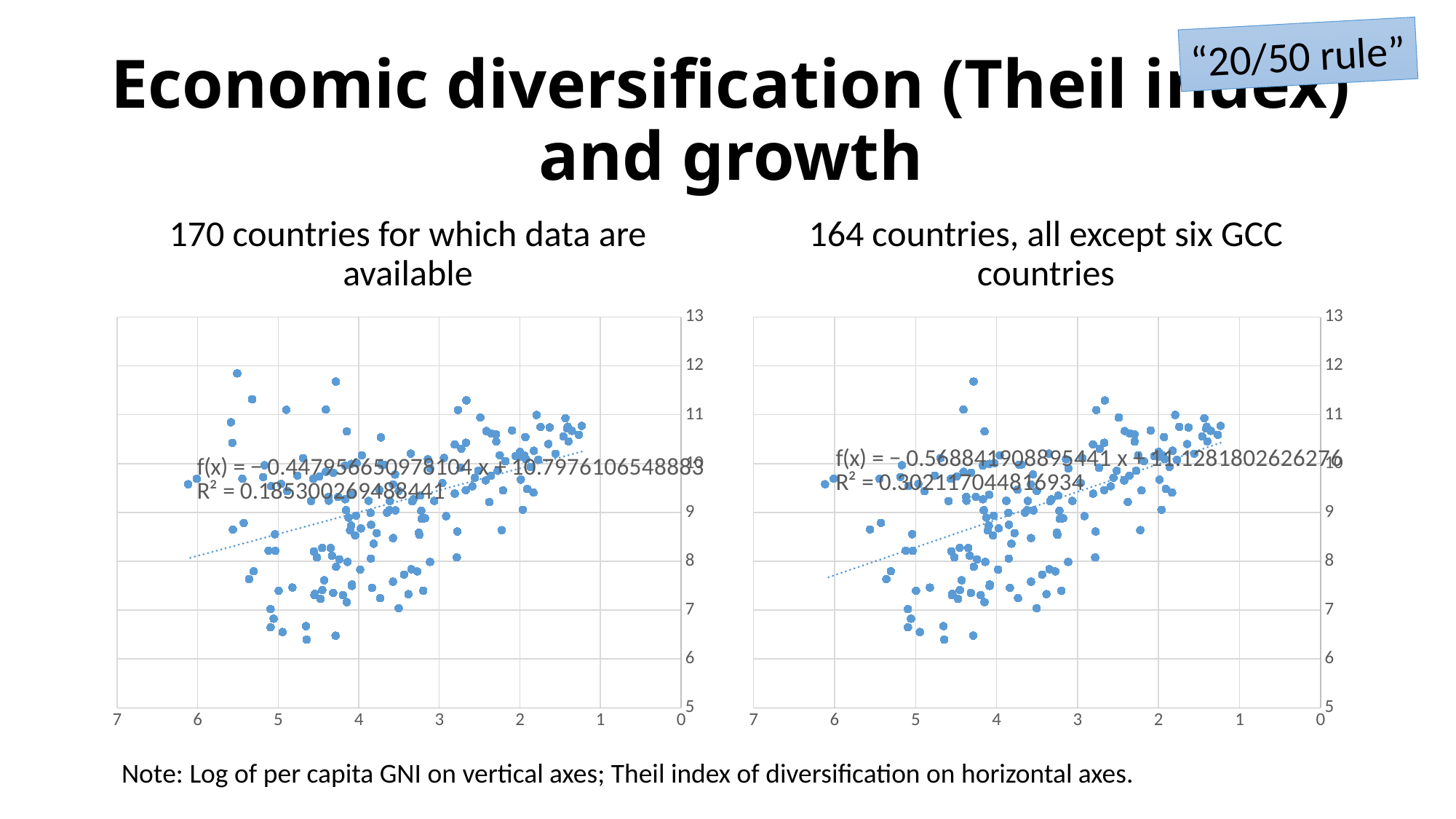
What kind of chart is shown on the left of the slide, titled '170 countries for which data are available'? scatter chart In the chart '170 countries for which data are available', what is the highest value shown on the vertical axis? 13 In the chart '170 countries for which data are available', what is the slope coefficient of x in the trendline equation? −0.447956650978104 In the chart '170 countries for which data are available', do the plotted points generally rise or fall moving from left to right along the horizontal axis? rise In the chart '164 countries, all except six GCC countries', what is the lowest value shown on the vertical axis? 5 How many charts are on the slide? 2 According to the note on the slide, what variable is plotted on the horizontal axes of the charts? Theil index of diversification In the chart '170 countries for which data are available', what is the R² value of the trendline? 0.185300269488441 In the chart '164 countries, all except six GCC countries', what is the R² value of the trendline? 0.302117044816934 In the chart '164 countries, all except six GCC countries', does the trendline rise or fall moving from left to right? rise In the chart '164 countries, all except six GCC countries', what is the slope coefficient of x in the trendline equation? −0.568841908895441 Which chart has the higher R² value, the left one (170 countries) or the right one (164 countries)? the right one (164 countries)